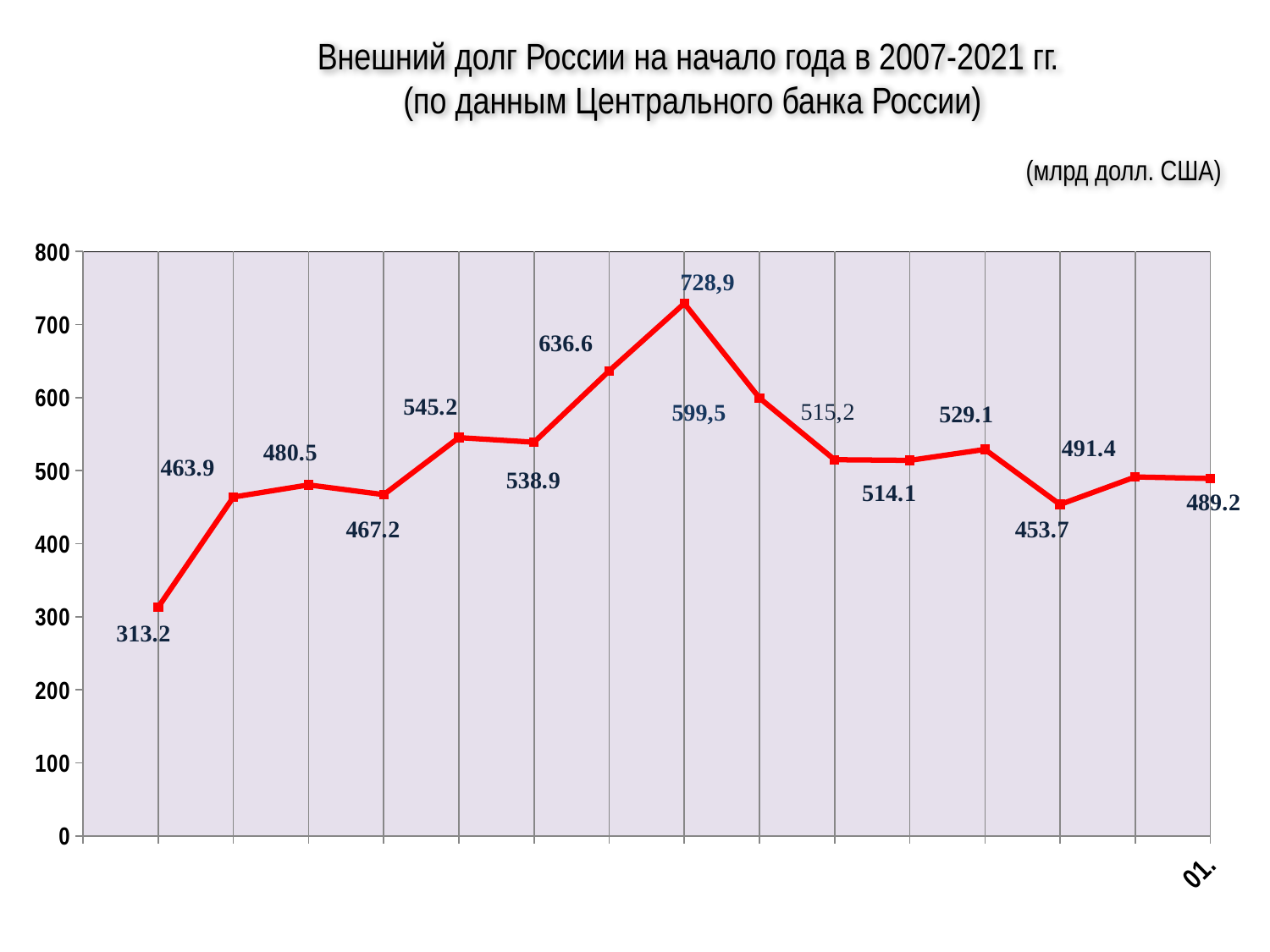
What is the lowest value shown on the chart? 313.2 What unit of measurement is stated above the chart? млрд долл. США What is the difference between the highest value (728,9) and the lowest value (313.2) on the chart? 415.7 Is the highest point on the line greater or less than 700? greater What is the value of the first (leftmost) point on the line? 313.2 What is the value of the last (rightmost) point on the line? 489.2 What kind of chart is shown on the slide? line chart Does the line rise or fall between the first point and the peak labelled 728,9? rises What is the maximum value shown on the vertical axis? 800 What is the highest value shown on the chart? 728,9 How many data points are plotted on the line? 15 Which is larger: the value of the first point (313.2) or the value of the last point (489.2)? 489.2 (the last point)